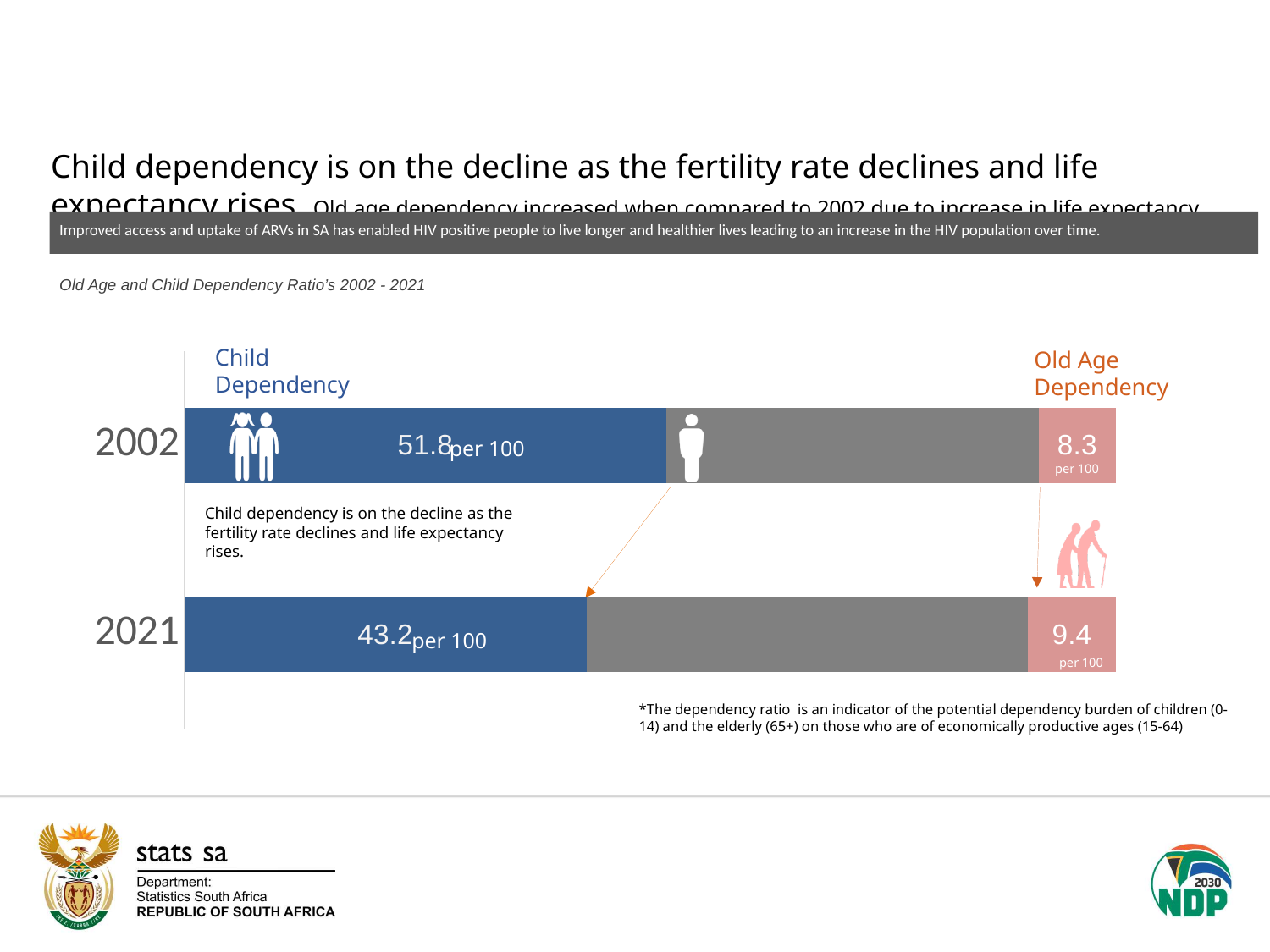
What is the child dependency ratio for 2021? 43.2 per 100 How many years are shown in the chart? 2 By how much did the old age dependency ratio rise from 2002 to 2021? 1.1 per 100 What kind of chart is shown on the slide? bar chart Which year has the higher old age dependency ratio, 2002 or 2021? 2021 What is the old age dependency ratio for 2021? 9.4 per 100 Does the child dependency ratio rise or fall from 2002 to 2021? fall What is the title of the chart? Old Age and Child Dependency Ratio's 2002 - 2021 By how much did the child dependency ratio fall from 2002 to 2021? 8.6 per 100 Which year has the higher child dependency ratio, 2002 or 2021? 2002 What is the child dependency ratio for 2002? 51.8 per 100 What is the old age dependency ratio for 2002? 8.3 per 100